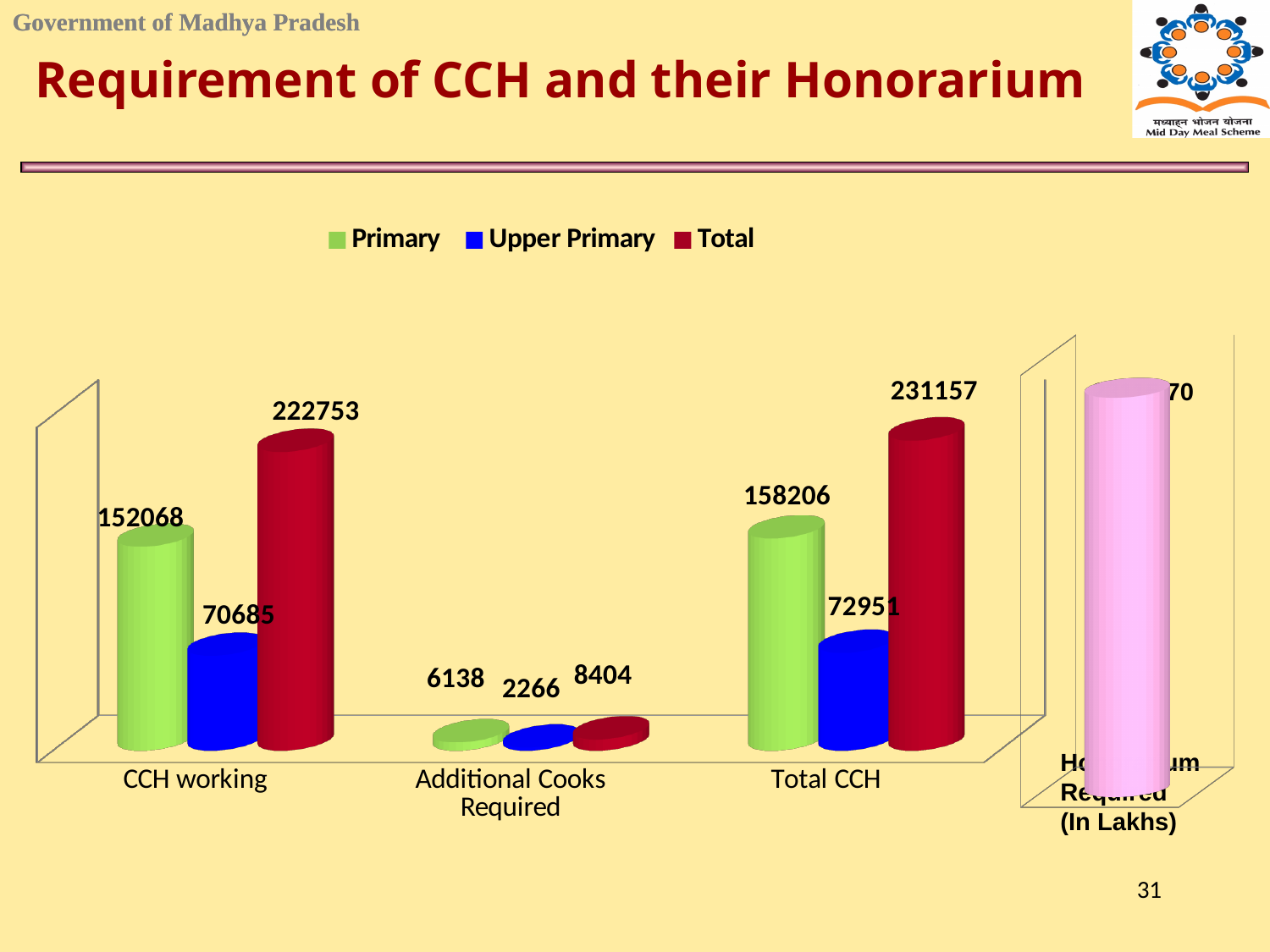
In the main bar chart, what is the difference between the Total values for Total CCH and CCH working? 8404 What kind of chart is the main chart on the slide? Bar chart In the main bar chart, what is the Total value for Additional Cooks Required? 8404 In the main bar chart, which category has the lowest Primary value? Additional Cooks Required In the main bar chart, what is the Upper Primary value for Total CCH? 72951 In the main bar chart, what is the Total value for CCH working? 222753 In the main bar chart, what is the difference between the Primary and Upper Primary values for CCH working? 81383 How many series does the legend of the main bar chart list? 3 In the main bar chart, which is larger: the Primary value for Total CCH or the Total value for CCH working? Total value for CCH working In the main bar chart, what is the Primary value for CCH working? 152068 How many categories are shown on the x axis of the main bar chart? 3 In the main bar chart, which category has the highest Total value? Total CCH